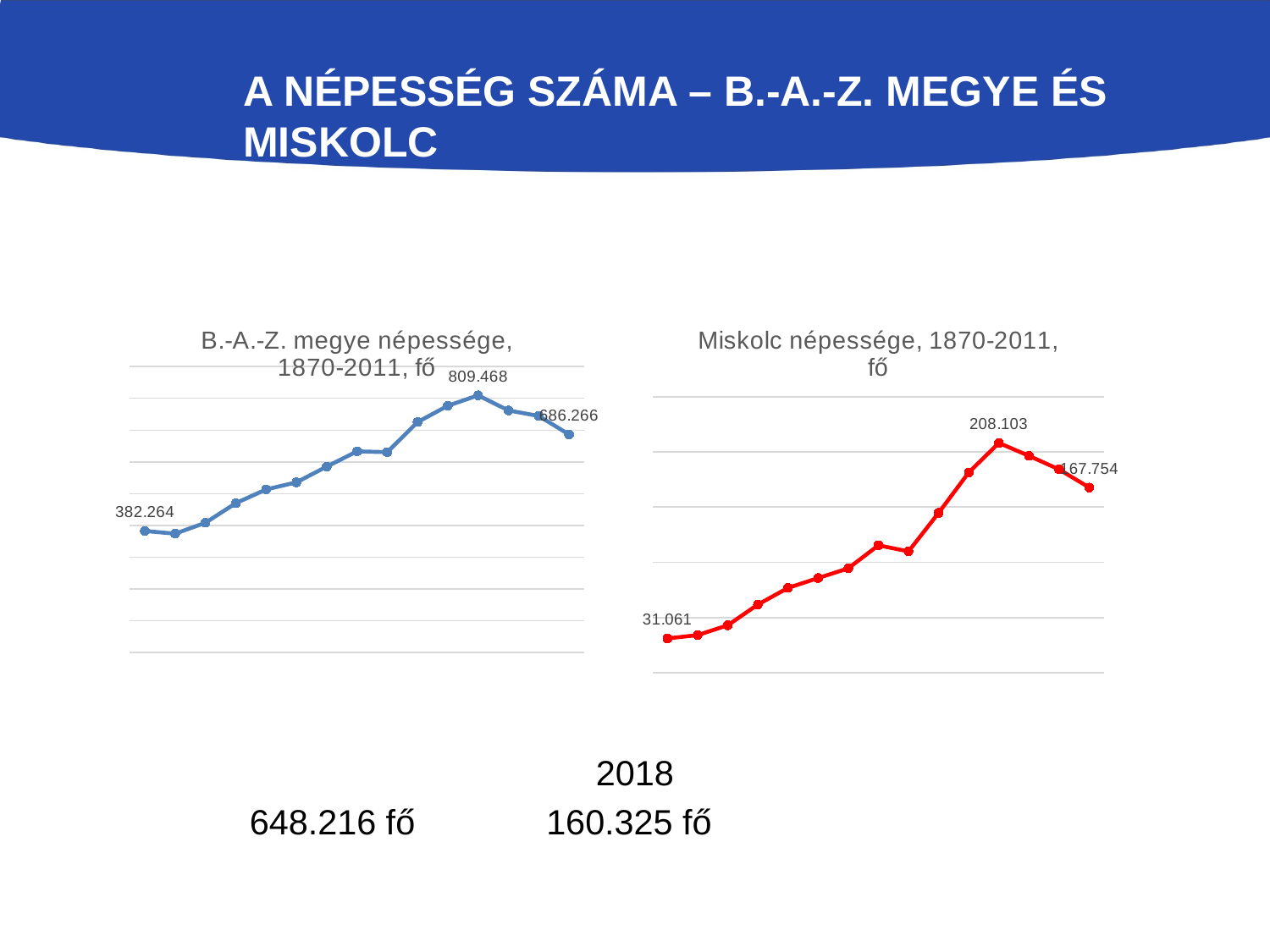
In the 'Miskolc népessége, 1870-2011, fő' chart, what is the highest labelled value? 208.103 In the 'Miskolc népessége, 1870-2011, fő' chart, what is the value labelled at the last data point? 167.754 In the 'B.-A.-Z. megye népessége, 1870-2011, fő' chart, what is the highest labelled value? 809.468 What colour is the line in the 'Miskolc népessége, 1870-2011, fő' chart? red In the 'Miskolc népessége, 1870-2011, fő' chart, what is the value labelled at the first data point? 31.061 In the 'B.-A.-Z. megye népessége, 1870-2011, fő' chart, what is the value labelled at the last data point? 686.266 In the 'Miskolc népessége, 1870-2011, fő' chart, which is larger: the first labelled value or the last labelled value? the last labelled value (167.754) What type of chart is the 'B.-A.-Z. megye népessége, 1870-2011, fő' chart? line chart In the 'B.-A.-Z. megye népessége, 1870-2011, fő' chart, what is the value labelled at the first data point? 382.264 In the 'Miskolc népessége, 1870-2011, fő' chart, do the values rise or fall after the peak point? fall In the 'B.-A.-Z. megye népessége, 1870-2011, fő' chart, what is the difference between the peak value and the first value? 427.204 In the 'Miskolc népessége, 1870-2011, fő' chart, what is the difference between the peak value and the last labelled value? 40.349